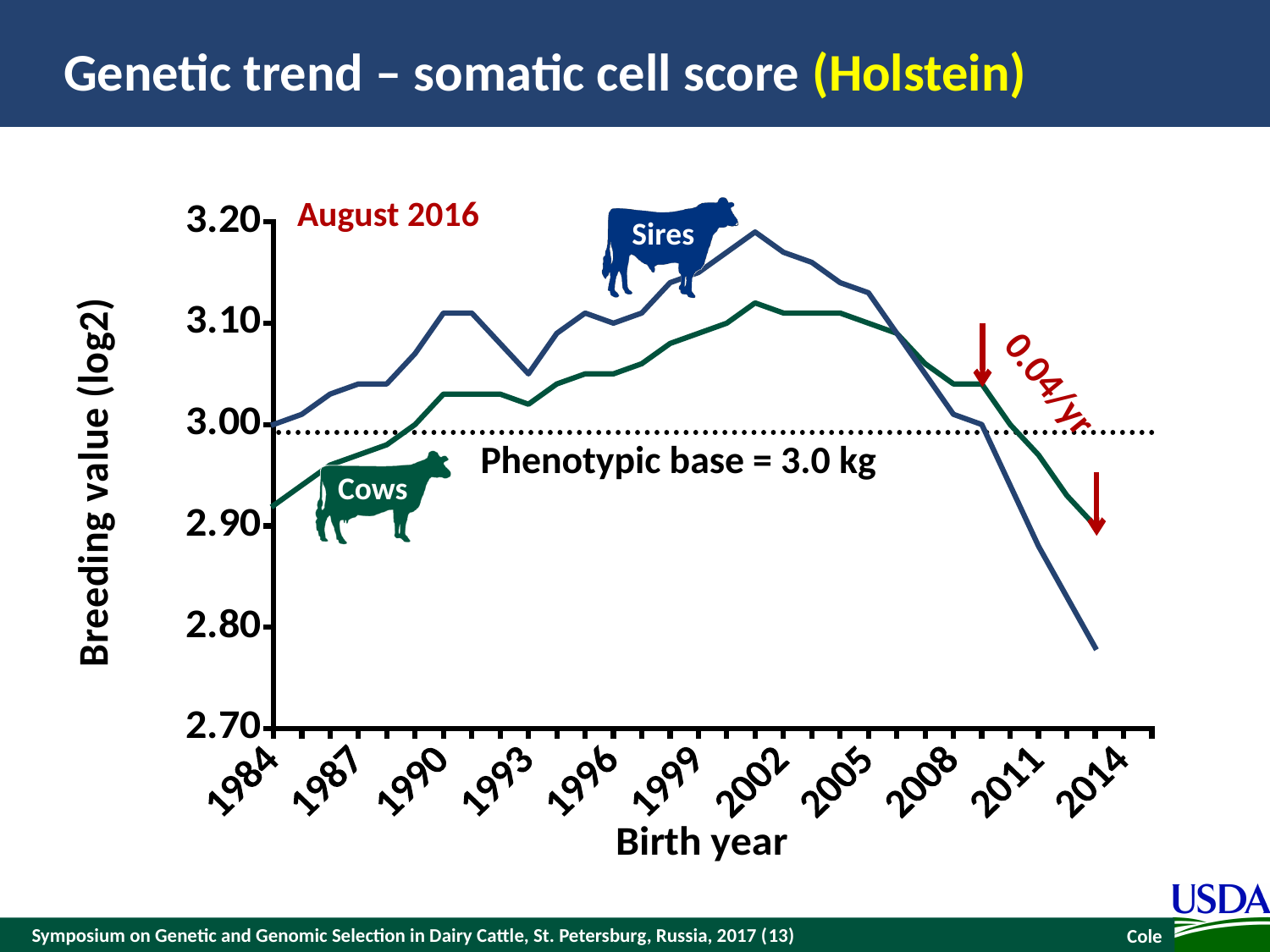
Is the Cows value for birth year 1984 greater or less than 3.00? less Do the breeding values for Sires rise or fall between birth years 2002 and 2014? fall In which birth year does the Sires line reach its lowest value? 2013 What kind of chart is shown on the slide? line chart For birth year 2002, which series has the higher breeding value, Sires or Cows? Sires How many series are plotted in the chart? 2 What value is the phenotypic base shown by the dotted line? 3.0 kg Which series reaches the highest breeding value in the chart? Sires Which two series are plotted in the chart? Sires and Cows Is the Sires value for birth year 2002 greater or less than 3.10? greater